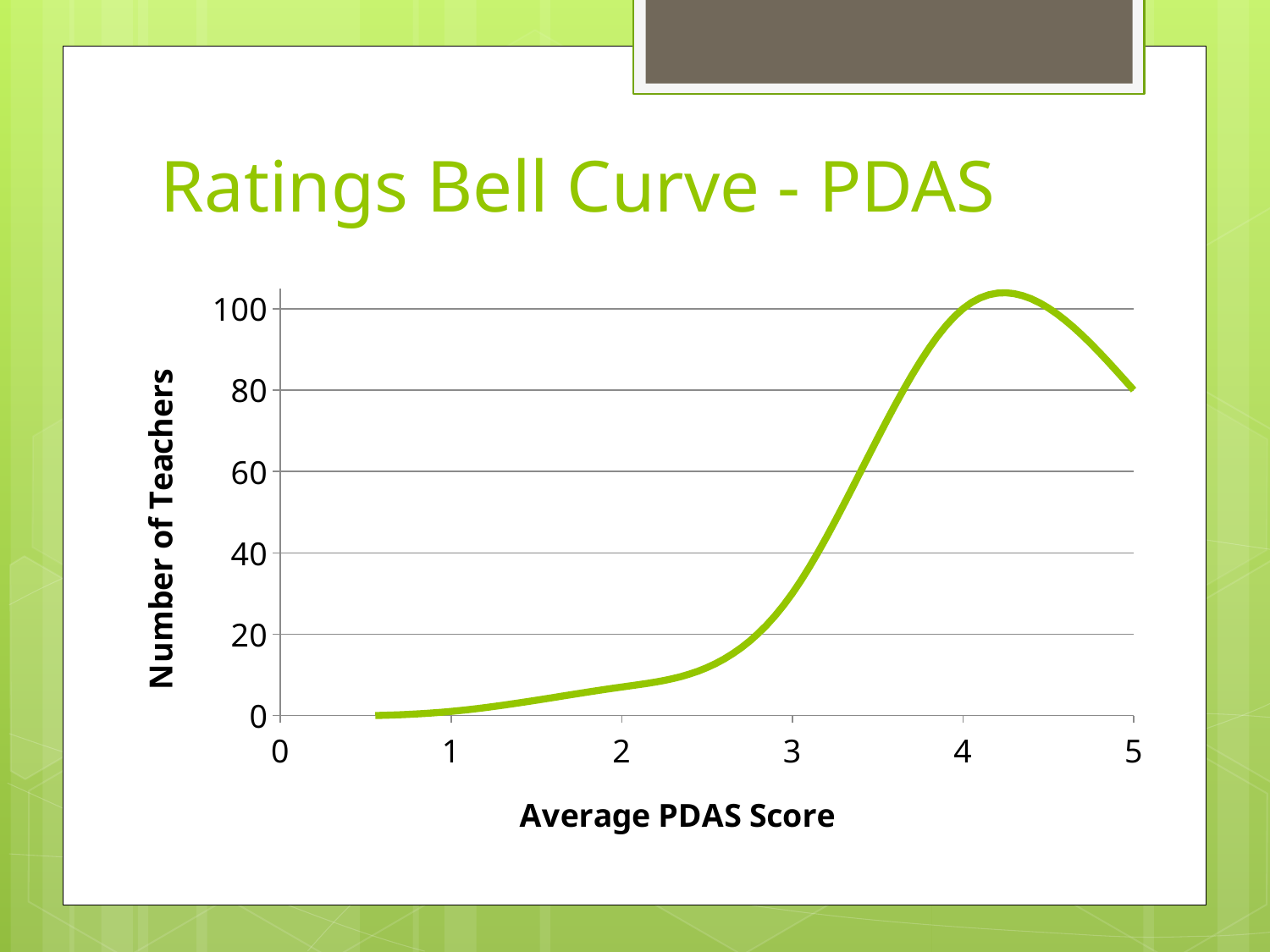
What is the label of the vertical axis? Number of Teachers Does the number of teachers rise or fall as the average PDAS score increases from 4.5 to 5? fall Is the number of teachers at an average PDAS score of 5 greater or less than 60? greater Is the number of teachers at an average PDAS score of 3.5 greater or less than 40? greater What kind of chart is shown on the slide? line chart Does the number of teachers rise or fall as the average PDAS score increases from 1 to 4? rise Is the number of teachers at an average PDAS score of 2 greater or less than 20? less Which has more teachers: an average PDAS score of 2 or an average PDAS score of 4? 4 What is the title of the chart? Ratings Bell Curve - PDAS Between which two x-axis ticks does the curve reach its highest point? 4 and 5